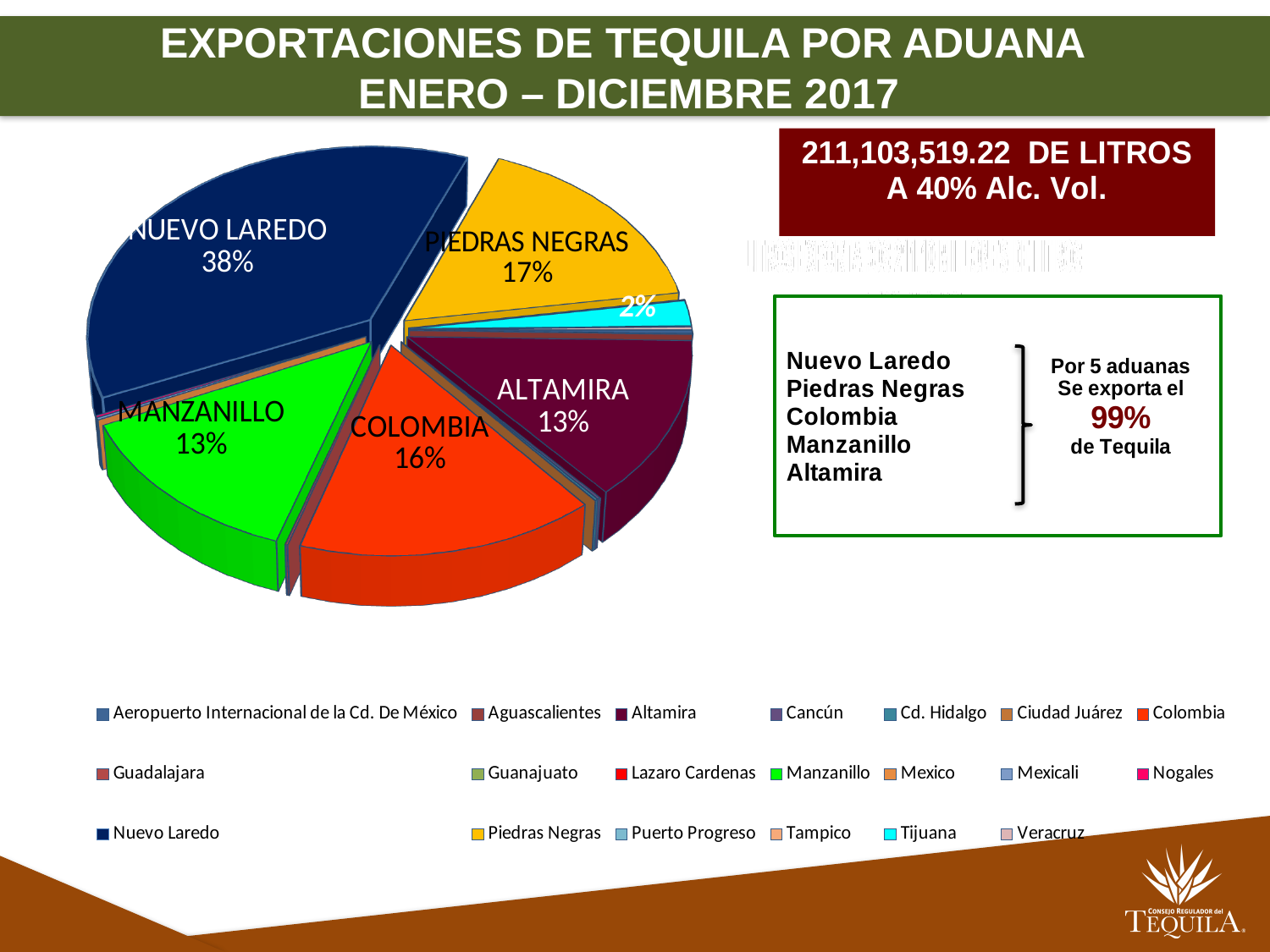
What share of the pie does Nuevo Laredo hold? 38% What percentage is shown for Colombia? 16% Which aduana has the largest slice of the pie? Nuevo Laredo By how many percentage points does Nuevo Laredo's share exceed Piedras Negras's share? 21 percentage points What percentage is shown for Piedras Negras? 17% Which has a larger share, Piedras Negras or Colombia? Piedras Negras By how many percentage points does Colombia's share exceed Altamira's share? 3 percentage points What percentage is shown for Altamira? 13% What colour is the Nuevo Laredo slice of the pie? dark blue What is the smallest percentage printed on any slice of the pie? 2% What percentage is shown for Manzanillo? 13% What kind of chart is shown on the slide? pie chart